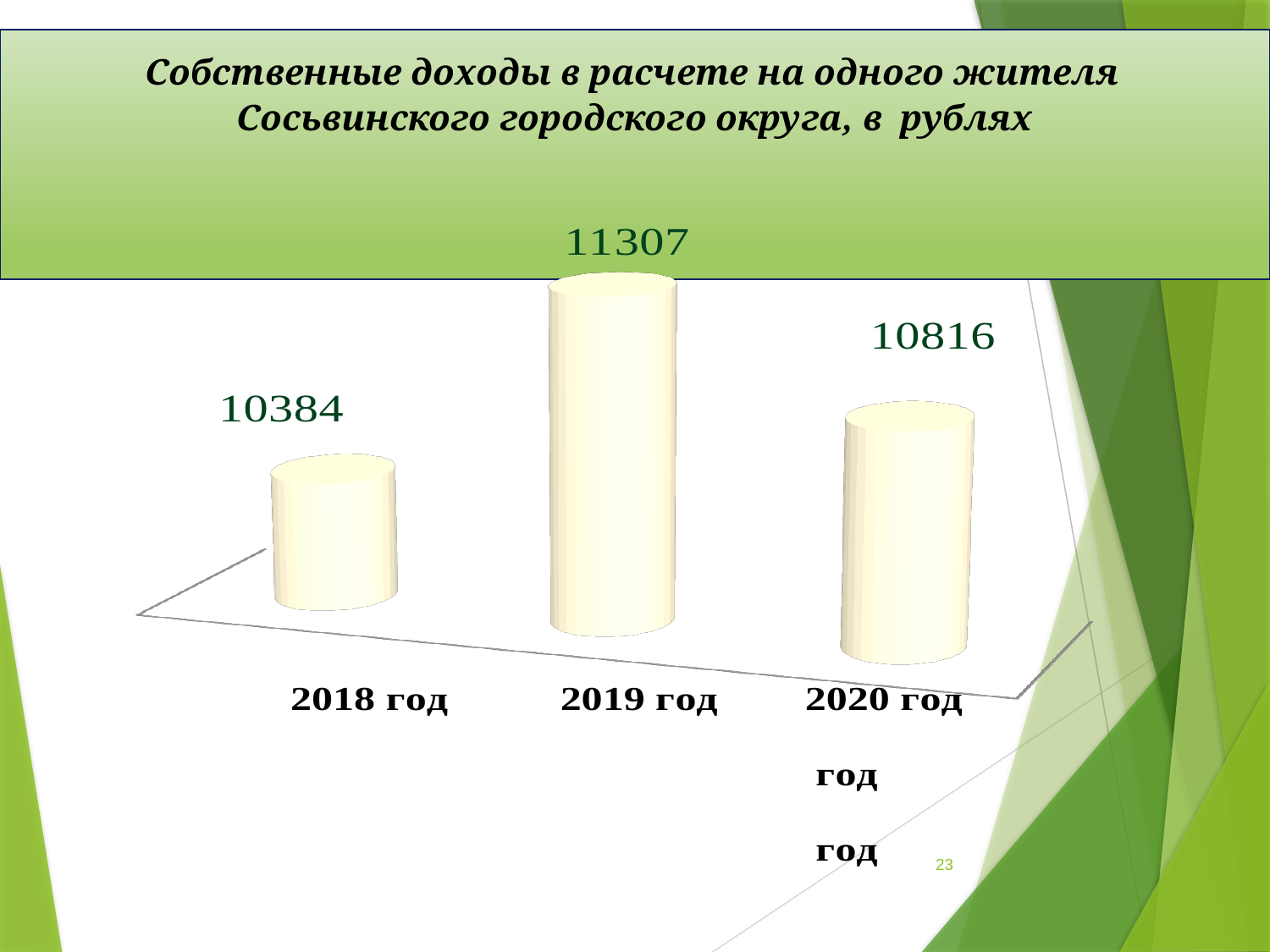
How many years are shown on the chart? 3 Which year has the lowest value? 2018 год What is the value for 2018 год? 10384 Which year has the highest value? 2019 год What is the difference between the values for 2019 год and 2018 год? 923 What is the value for 2019 год? 11307 What is the difference between the values for 2020 год and 2018 год? 432 What is the value for 2020 год? 10816 What kind of chart is shown on the slide? bar chart What is the difference between the values for 2019 год and 2020 год? 491 What is the title of the chart? Собственные доходы в расчете на одного жителя Сосьвинского городского округа, в рублях Which is larger, the value for 2020 год or the value for 2018 год? 2020 год